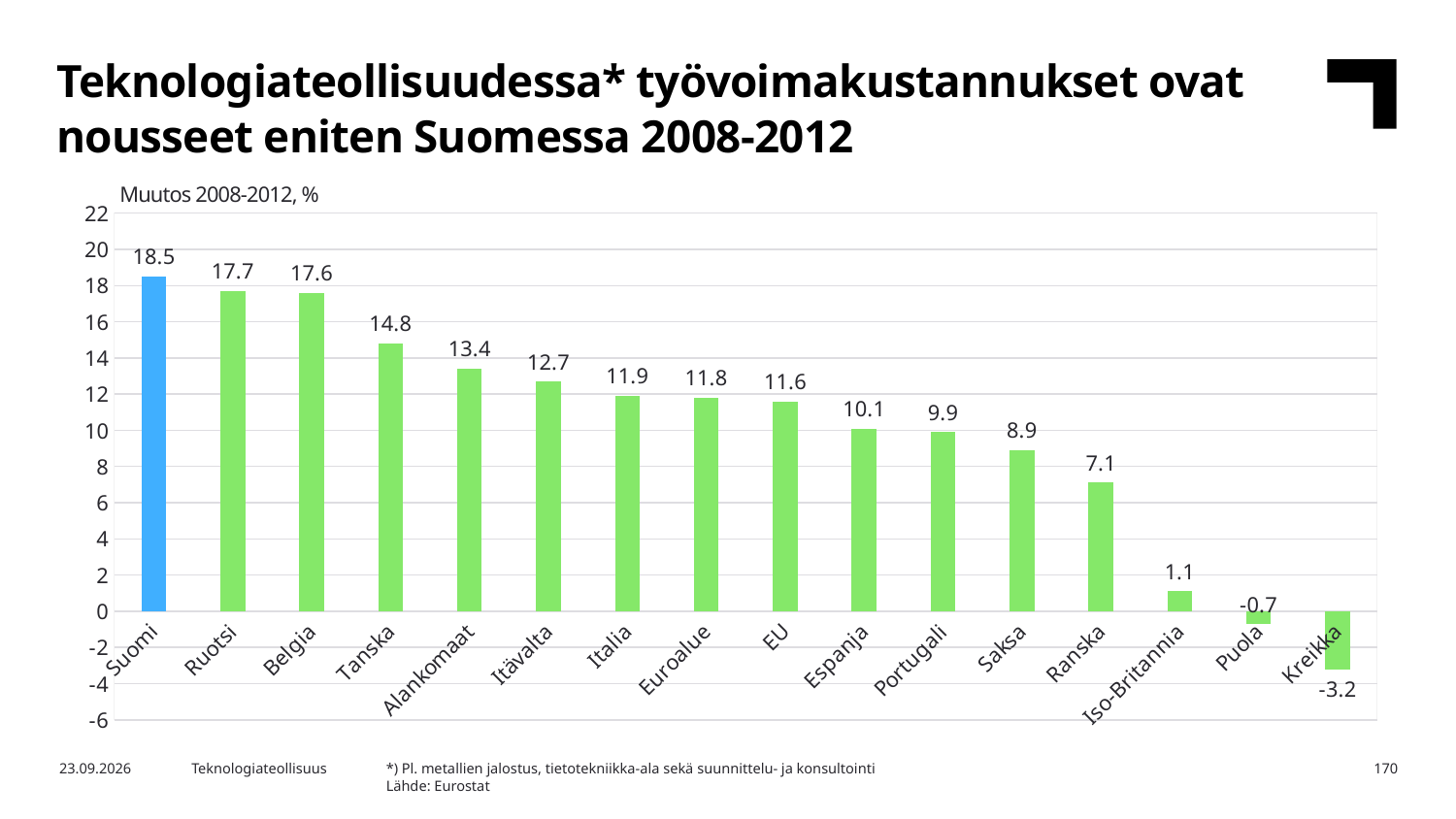
Which country has the highest value? Suomi Which country has the lowest value? Kreikka How many countries or regions are shown on the chart? 16 Which bar is coloured differently from the others? Suomi Do the values rise or fall from left to right along the x axis? fall What is the value for Suomi? 18.5 Which is larger, the value for Tanska or the value for Espanja? Tanska What is the value for Kreikka? -3.2 Is the value for Ranska greater or less than 8? less What is the value for Alankomaat? 13.4 What kind of chart is shown on the slide? bar chart What is the difference between the values for Suomi and Saksa? 9.6